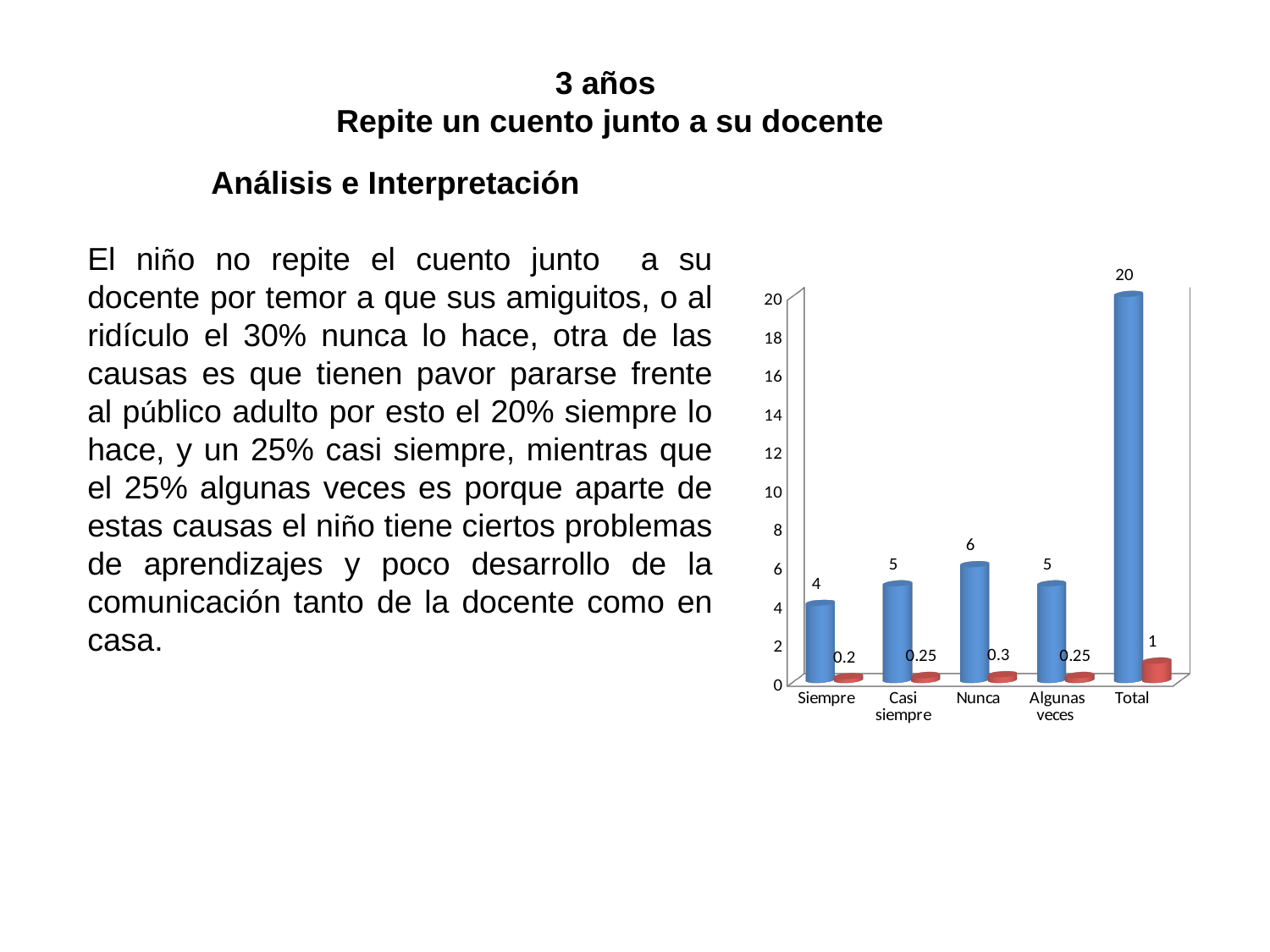
What is the value of the red bar for Casi siempre? 0.25 Which category has the lowest blue bar? Siempre Which is larger, the blue bar for Casi siempre or the blue bar for Siempre? Casi siempre What is the difference between the blue bar values for Nunca and Siempre? 2 Is the blue bar for Total greater or less than 10? greater Excluding Total, which category has the highest blue bar? Nunca How many categories are shown on the x axis? 5 What kind of chart is shown on the slide? bar chart What is the value of the red bar for Siempre? 0.2 What is the value of the blue bar for Nunca? 6 What is the value of the blue bar for Total? 20 What colour are the bars with the larger values in the chart? blue